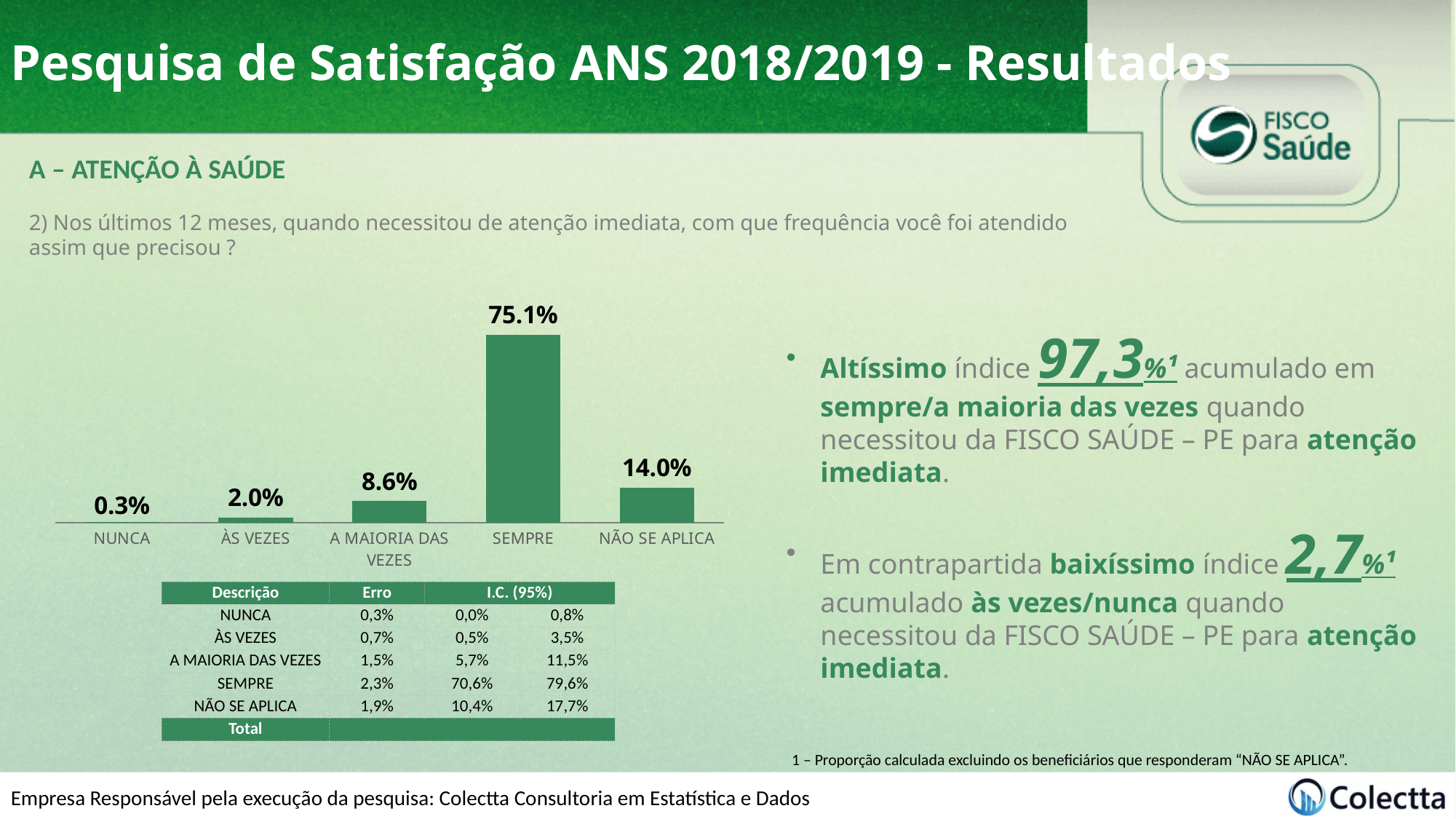
What is the value for SEMPRE in the bar chart? 75.1% Which is larger, the value for NÃO SE APLICA or the value for A MAIORIA DAS VEZES? NÃO SE APLICA What kind of chart is shown on the slide? bar chart What is the value for A MAIORIA DAS VEZES in the bar chart? 8.6% What is the value for NÃO SE APLICA in the bar chart? 14.0% What is the difference between the values for SEMPRE and NÃO SE APLICA? 61.1% Which category has the lowest value in the bar chart? NUNCA How many categories are shown in the bar chart? 5 What is the difference between the values for A MAIORIA DAS VEZES and ÀS VEZES? 6.6% What is the value for ÀS VEZES in the bar chart? 2.0% Which category has the highest value in the bar chart? SEMPRE What is the value for NUNCA in the bar chart? 0.3%